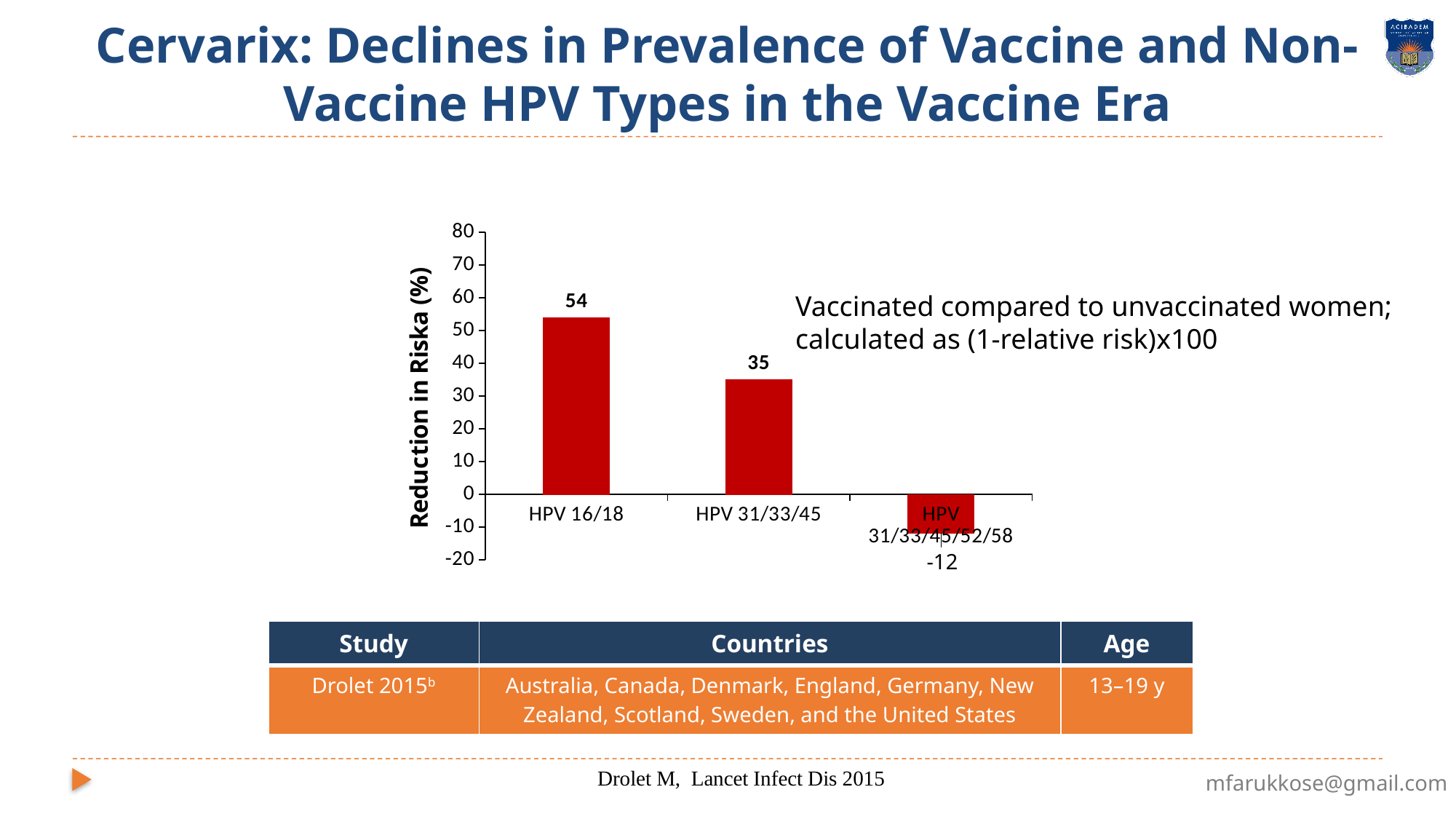
Is the value for HPV 16/18 greater or less than 50? greater Which has a larger reduction in risk, HPV 31/33/45 or HPV 31/33/45/52/58? HPV 31/33/45 Which HPV type group has the highest reduction in risk? HPV 16/18 What is the difference in reduction in risk between HPV 16/18 and HPV 31/33/45? 19 What is the reduction in risk (%) for HPV 31/33/45? 35 What is the reduction in risk (%) for HPV 31/33/45/52/58? -12 What kind of chart is shown on the slide? bar chart What is the label of the y axis of the chart? Reduction in Riska (%) What is the reduction in risk (%) for HPV 16/18? 54 Which HPV type group has the lowest reduction in risk? HPV 31/33/45/52/58 How many HPV type groups are shown on the chart? 3 Do the values rise or fall from left to right across the HPV type groups? fall